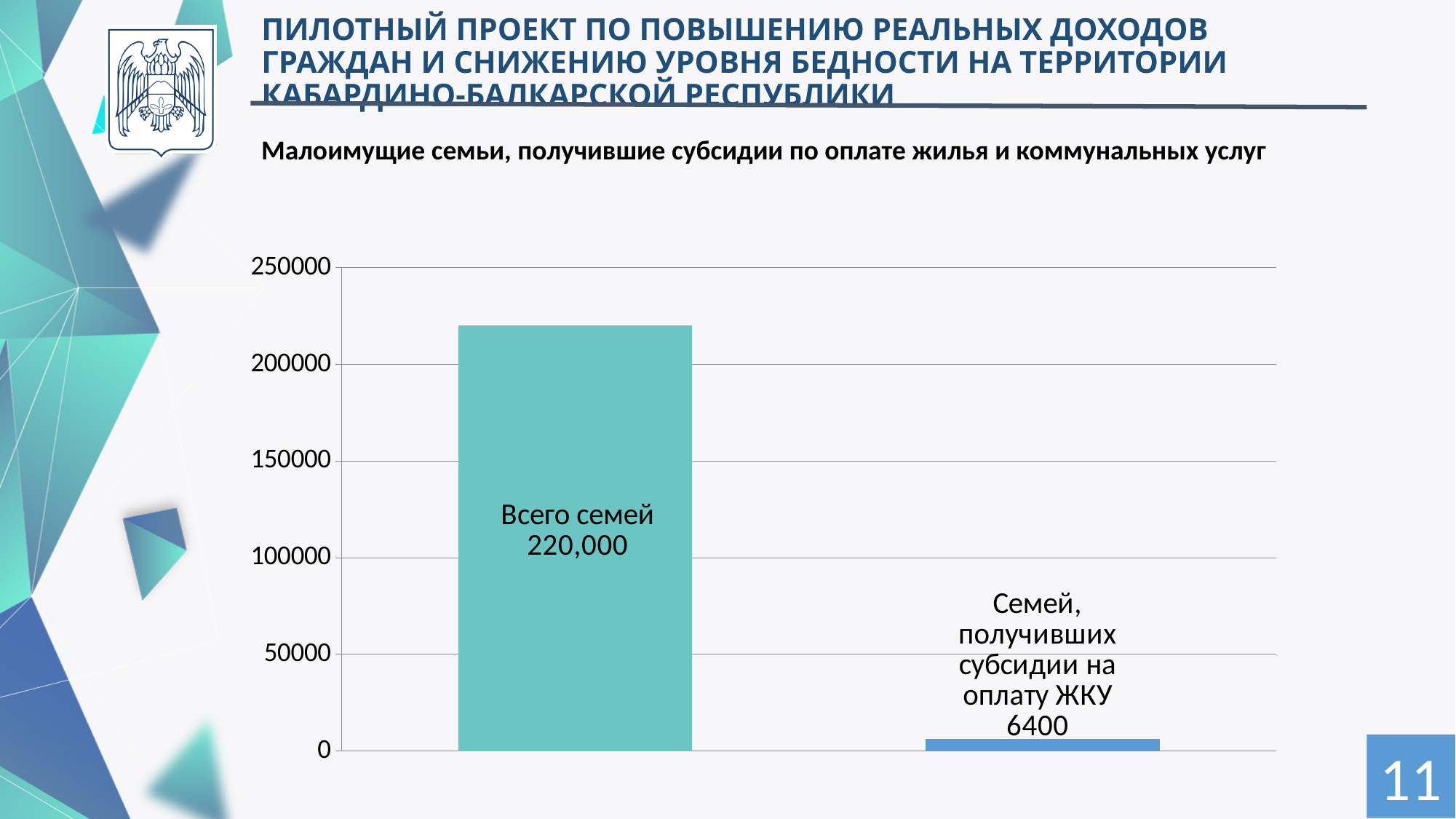
Is the value for "Всего семей" greater or less than 200000? greater What is the difference between the value for "Всего семей" and the value for "Семей, получивших субсидии на оплату ЖКУ"? 213,600 How many bars are plotted in the chart? 2 Which category has the lowest value? Семей, получивших субсидии на оплату ЖКУ Which category has the highest value? Всего семей Which is larger: the value for "Всего семей" or the value for "Семей, получивших субсидии на оплату ЖКУ"? Всего семей What is the title of the chart? Малоимущие семьи, получившие субсидии по оплате жилья и коммунальных услуг What type of chart is shown on the slide? bar chart What is the value shown for "Семей, получивших субсидии на оплату ЖКУ"? 6400 Is the value for "Семей, получивших субсидии на оплату ЖКУ" greater or less than 50000? less What is the value shown for "Всего семей"? 220,000 What is the maximum value shown on the vertical axis? 250000